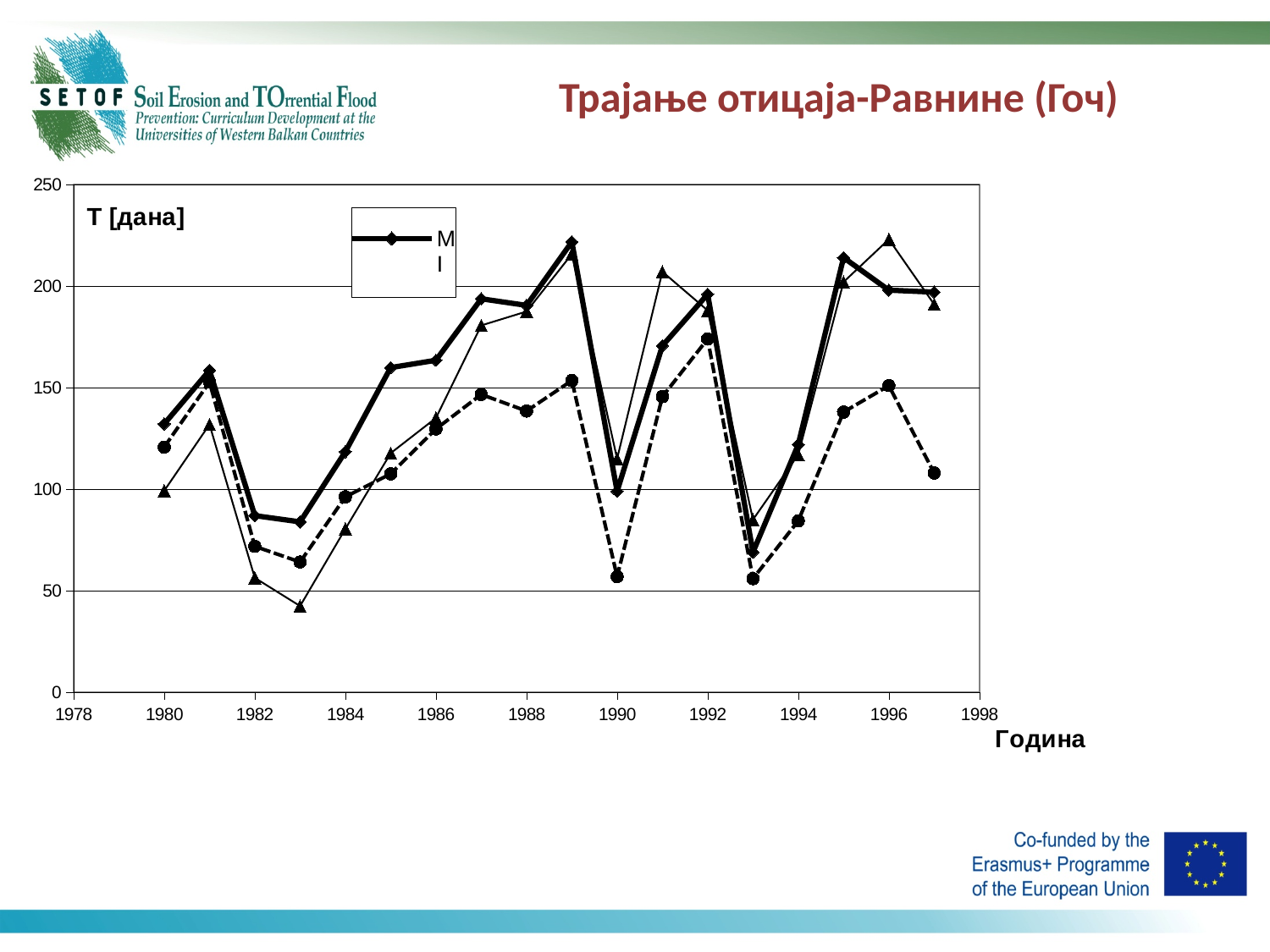
Is the value of the dashed circle-marker line in 1990 greater or less than 100? less In which year does the thick diamond-marker line reach its lowest value? 1993 What label is shown on the x axis of the chart? Година In which year does the dashed circle-marker line reach its highest value? 1992 What kind of chart is shown on the slide? line chart Is the value of the thick diamond-marker line in 1989 greater or less than 200? greater In which year does the thick diamond-marker line reach its highest value? 1989 Is the value of the thin triangle-marker line in 1983 greater or less than 50? less Which year has the larger value on the thick diamond-marker line, 1989 or 1990? 1989 What is the title of the chart on the slide? Трајање отицаја-Равнине (Гоч) In which year does the thin triangle-marker line reach its lowest value? 1983